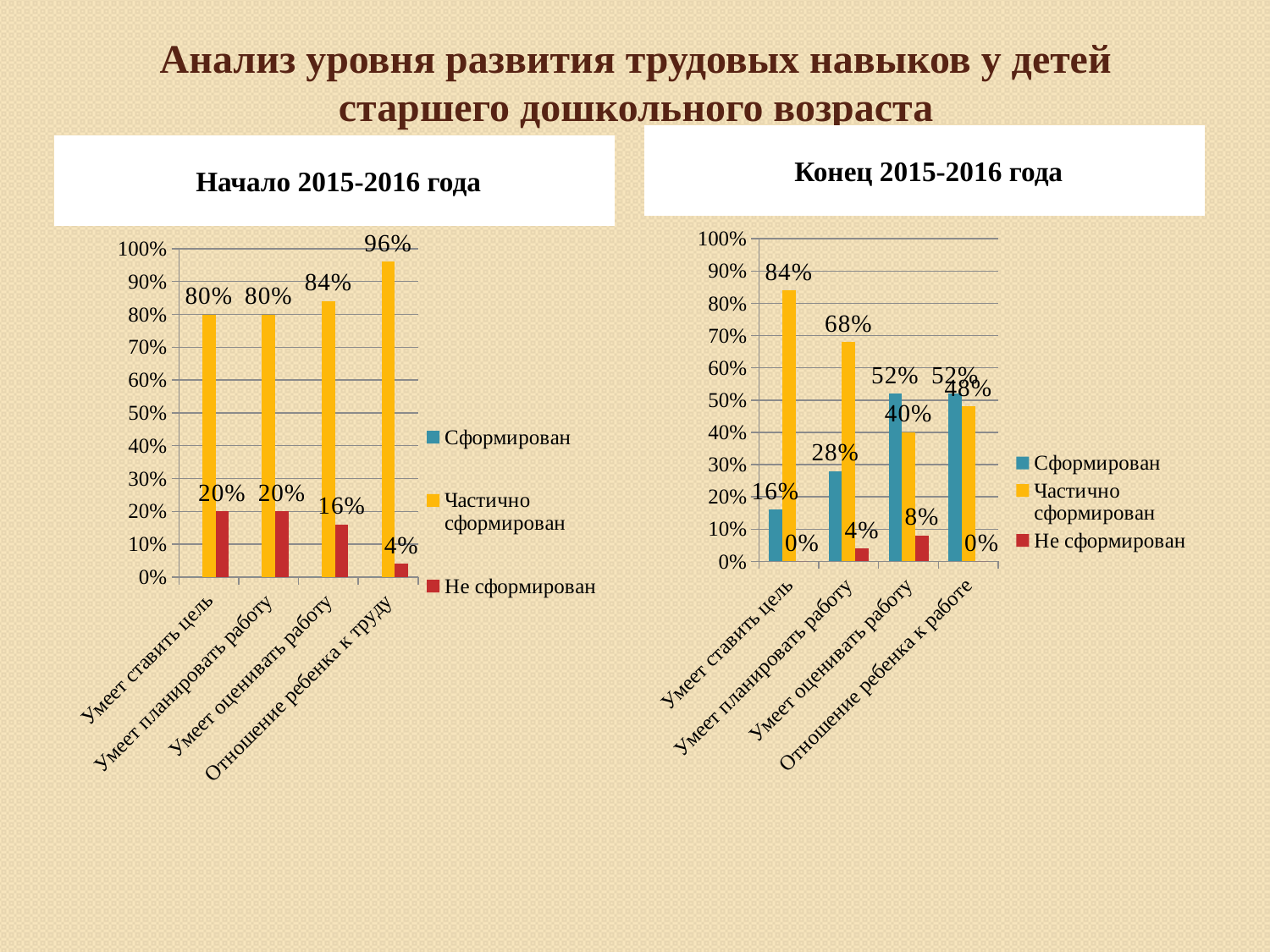
In the chart titled "Конец 2015-2016 года", which category has the highest "Не сформирован" value? Умеет оценивать работу In the chart titled "Начало 2015-2016 года", what is the difference between the "Частично сформирован" and "Не сформирован" values for "Умеет ставить цель"? 60% In the chart titled "Конец 2015-2016 года", which is larger for "Умеет оценивать работу": "Сформирован" or "Частично сформирован"? Сформирован In the chart titled "Начало 2015-2016 года", how many series does the legend list? 3 In the chart titled "Начало 2015-2016 года", which category has the lowest "Не сформирован" value? Отношение ребенка к труду In the chart titled "Конец 2015-2016 года", what is the value of "Сформирован" for "Умеет планировать работу"? 28% What kind of chart is the chart titled "Конец 2015-2016 года"? Bar chart In the chart titled "Конец 2015-2016 года", how many categories are shown on the x axis? 4 In the chart titled "Конец 2015-2016 года", what is the difference between the "Частично сформирован" values for "Умеет ставить цель" and "Умеет планировать работу"? 16% In the chart titled "Конец 2015-2016 года", what is the value of "Частично сформирован" for "Умеет ставить цель"? 84% In the chart titled "Начало 2015-2016 года", what is the value of "Не сформирован" for "Умеет оценивать работу"? 16% In the chart titled "Начало 2015-2016 года", what is the value of "Частично сформирован" for "Отношение ребенка к труду"? 96%